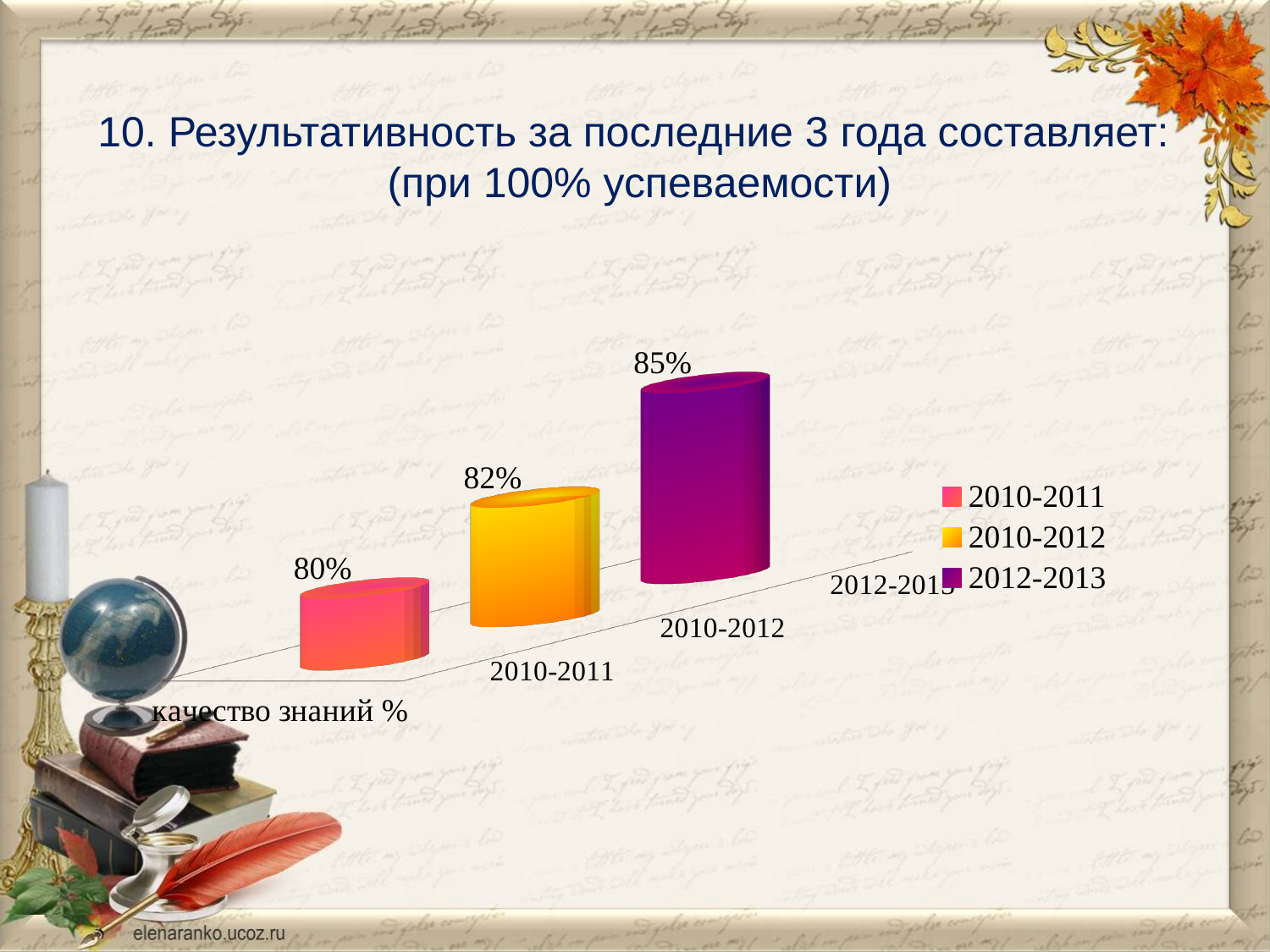
Which period has the highest value? 2012-2013 What is the value for 2012-2013? 85% What is the value for 2010-2012? 82% Which period has the lowest value? 2010-2011 What is the difference between the values for 2012-2013 and 2010-2011? 5% What is the value for 2010-2011? 80% What kind of chart is shown on the slide? bar chart How many bars are shown in the chart? 3 What is the difference between the values for 2010-2012 and 2010-2011? 2% Do the values rise or fall from 2010-2011 to 2012-2013? rise Which is larger, the value for 2010-2012 or the value for 2012-2013? 2012-2013 How many entries does the legend list? 3